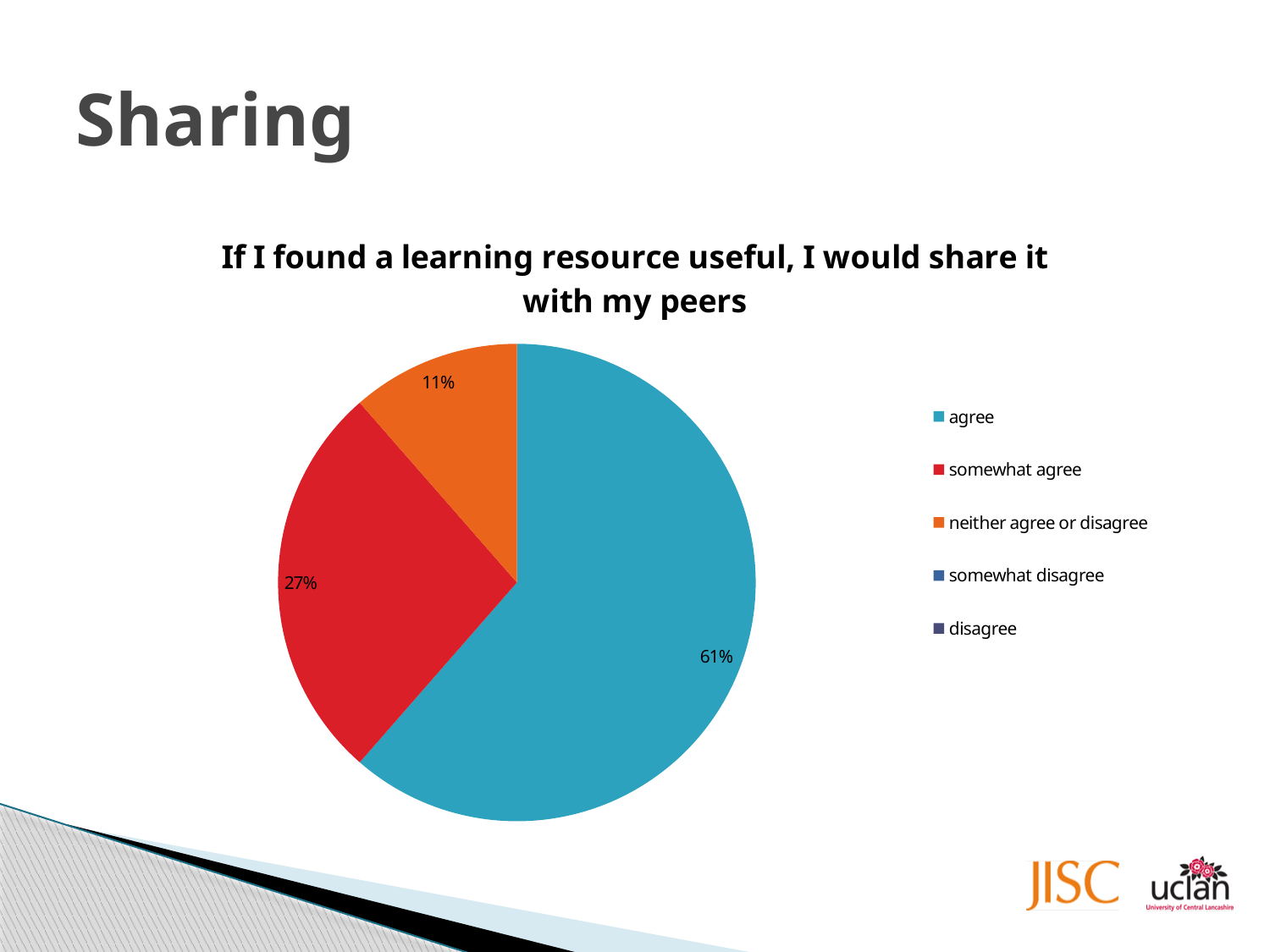
What is the difference in percentage points between "agree" and "somewhat agree"? 34 Which response has the largest share of the pie? agree What colour is the "agree" slice? blue What percentage of respondents chose "somewhat agree"? 27% What is the title of the chart? If I found a learning resource useful, I would share it with my peers What percentage of respondents chose "neither agree or disagree"? 11% Which of the visible slices has the smallest share of the pie? neither agree or disagree Which is larger, the share for "somewhat agree" or the share for "neither agree or disagree"? somewhat agree How many slices are visible in the pie chart? 3 What percentage of respondents chose "agree"? 61% How many entries does the legend list? 5 What kind of chart is shown on the slide? pie chart